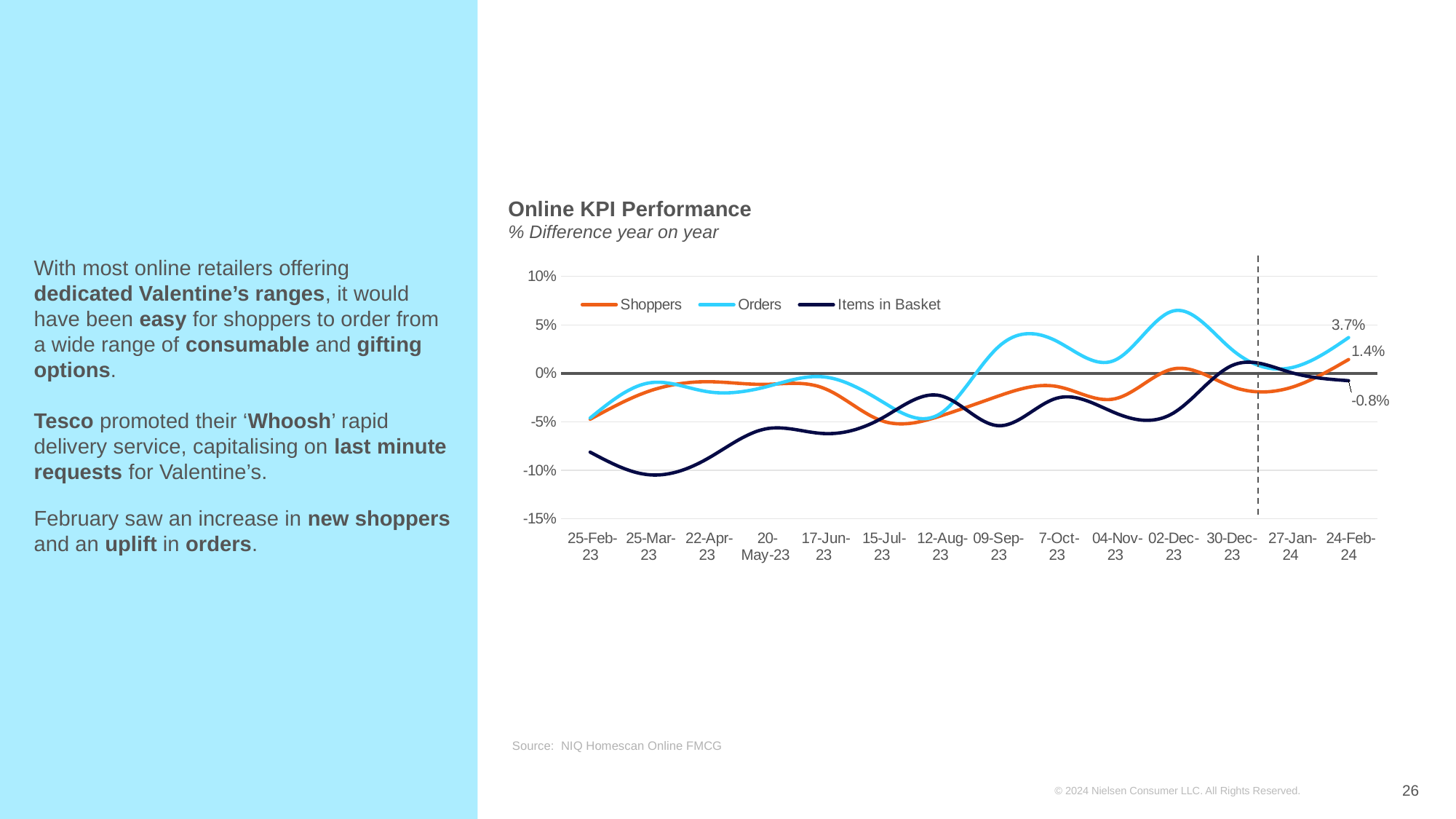
What kind of chart is shown on the slide? line chart What is the subtitle shown under the chart title 'Online KPI Performance'? % Difference year on year How many dates are labelled on the x axis of the chart? 14 What is the value for Items in Basket at 24-Feb-24? -0.8% What is the value for Shoppers at 24-Feb-24? 1.4% At 24-Feb-24, which is larger: Shoppers or Items in Basket? Shoppers At 24-Feb-24, which series has the highest value? Orders What is the difference between the Orders value and the Shoppers value at 24-Feb-24? 2.3% How many series does the legend of the Online KPI Performance chart list? 3 What is the value for Orders at 24-Feb-24? 3.7% Is the value for Items in Basket at 25-Feb-23 greater or less than -5%? less Is the value for Orders at 02-Dec-23 greater or less than 5%? greater